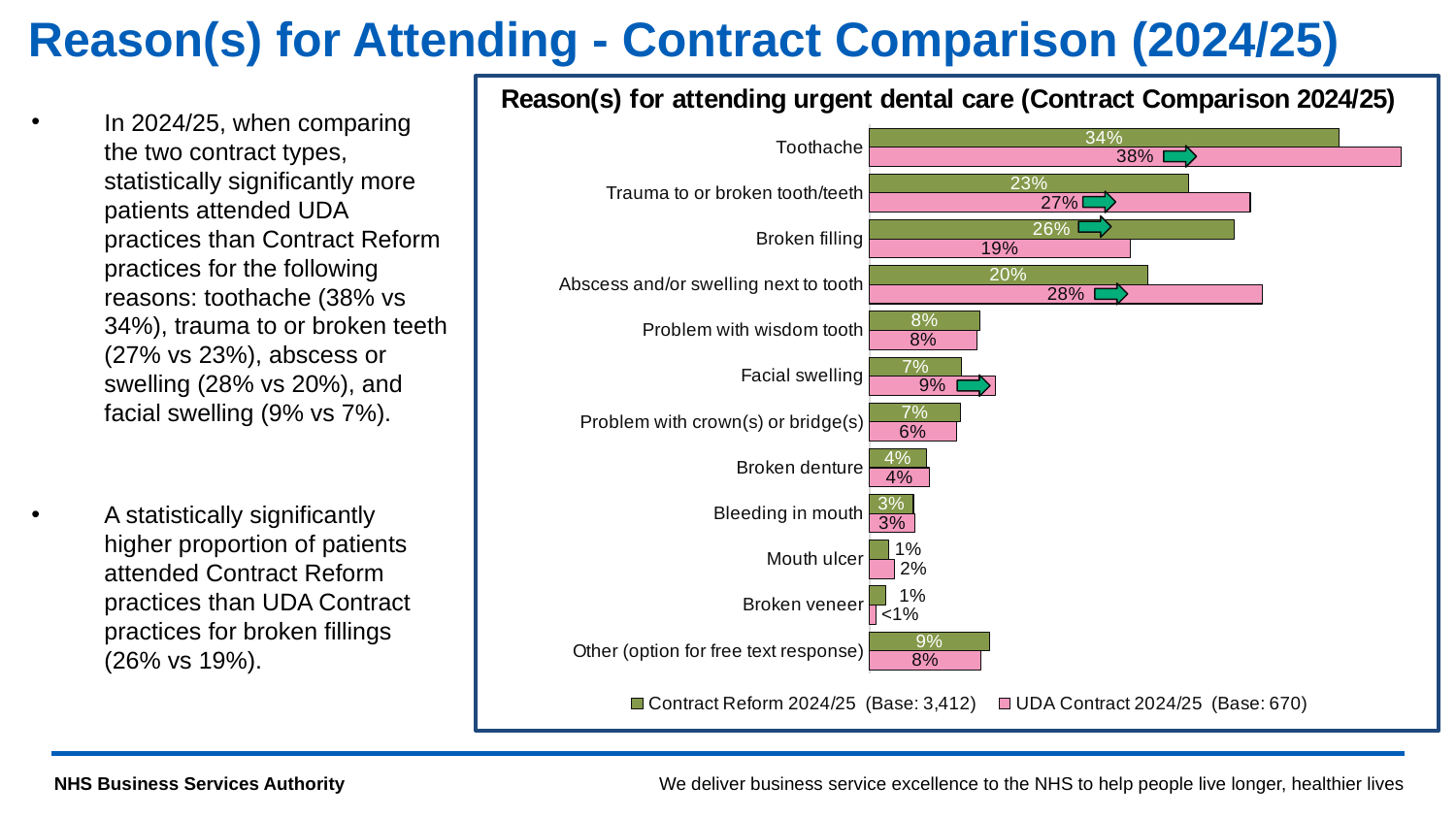
Which reason has the highest value in the Contract Reform 2024/25 series? Toothache What is the difference between the UDA Contract and Contract Reform values for Abscess and/or swelling next to tooth? 8% What is the value for Abscess and/or swelling next to tooth in the UDA Contract 2024/25 series? 28% How many series does the legend list? 2 How many reasons for attending are listed on the chart? 12 What kind of chart is shown on the slide? Bar chart What is the value for Toothache in the UDA Contract 2024/25 series? 38% What is the title of the chart? Reason(s) for attending urgent dental care (Contract Comparison 2024/25) Which is larger for Broken filling: the Contract Reform 2024/25 value or the UDA Contract 2024/25 value? Contract Reform 2024/25 What is the value for Broken filling in the Contract Reform 2024/25 series? 26% Which reason has the lowest value in the UDA Contract 2024/25 series? Broken veneer What is the base (number of respondents) for the Contract Reform 2024/25 series shown in the legend? 3,412